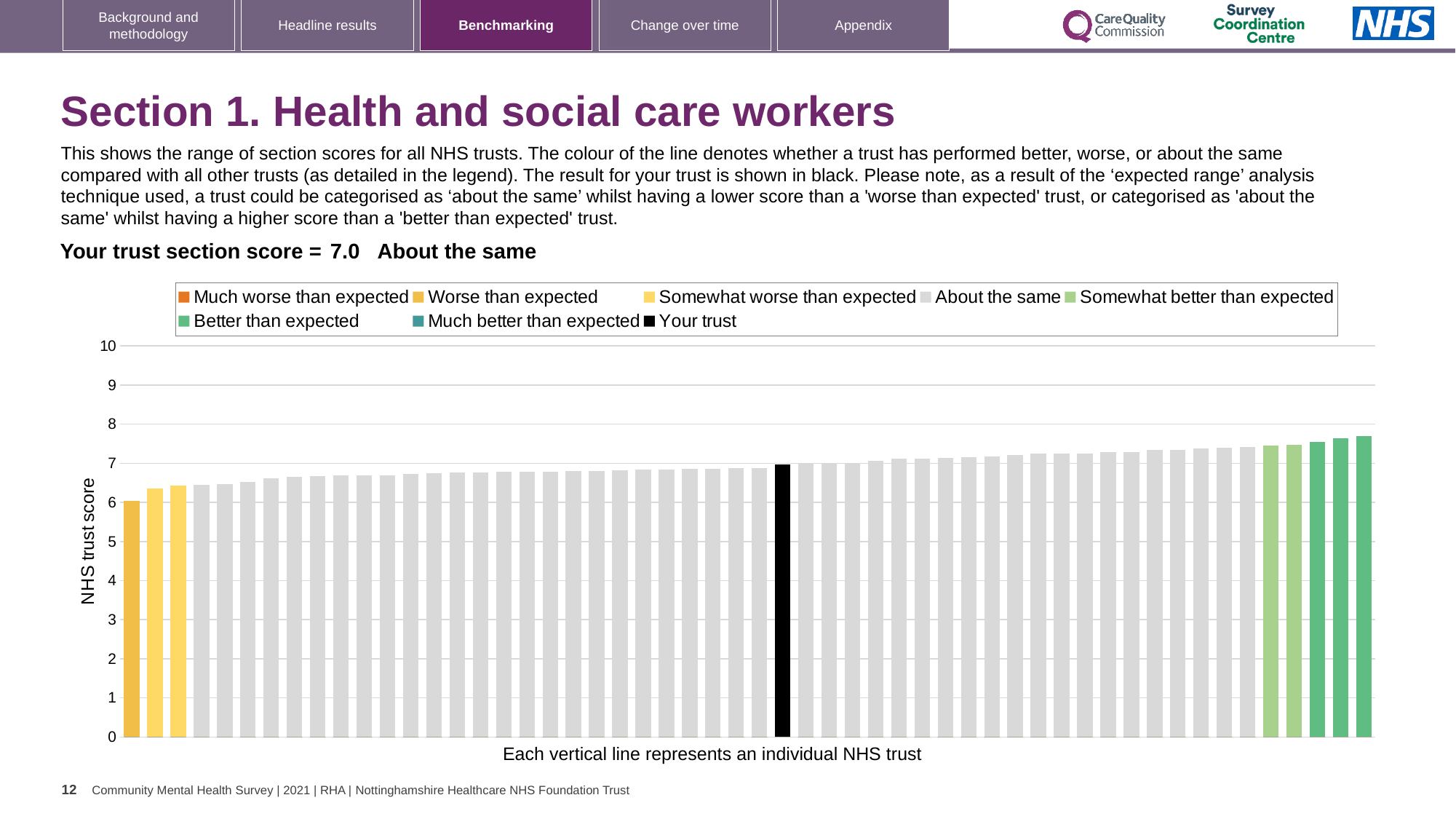
How many bars are coloured as 'Better than expected'? 3 Do the bar values rise or fall from left to right along the x axis? rise Is the value of the lowest bar greater or less than 5? greater Is the value of the black bar for your trust greater or less than 6? greater What is the section score for your trust shown on the slide? 7.0 Is the value of the highest bar greater or less than 8? less Which category is your trust placed in according to the text above the chart? About the same How many bars are coloured as 'Somewhat better than expected'? 2 What is the label on the vertical axis of the chart? NHS trust score How many bars are coloured as 'Worse than expected'? 1 What kind of chart is shown on the slide? bar chart How many entries does the chart legend list? 8